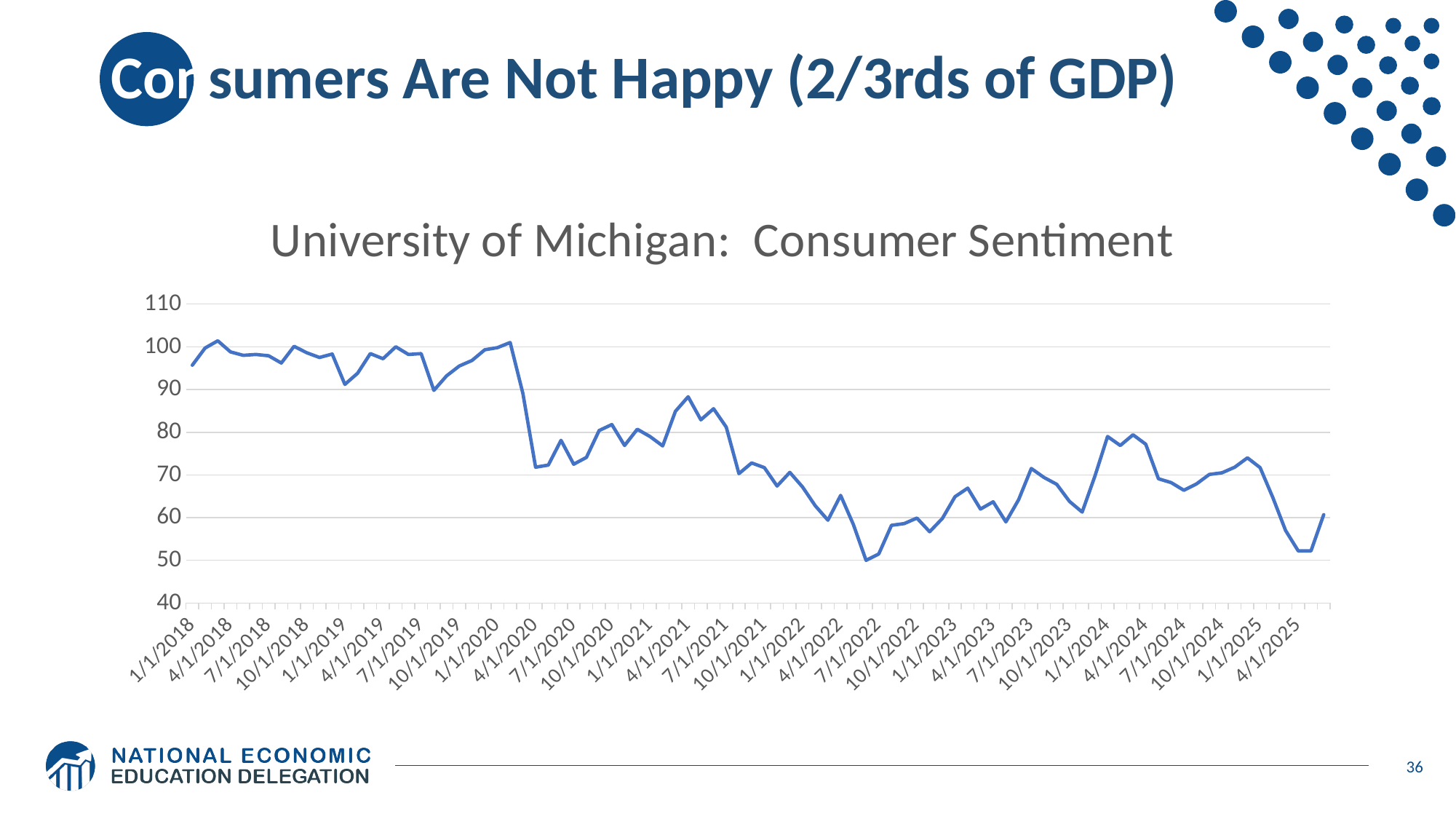
Which is larger, the value for 1/1/2018 or the value for 1/1/2022? 1/1/2018 How many date labels are shown on the x axis? 30 Which is larger, the value for 4/1/2021 or the value for 4/1/2022? 4/1/2021 What kind of chart is shown on the slide? Line chart Is the value for 7/1/2022 greater or less than 60? less Is the value for 4/1/2025 greater or less than 60? less Is the value for 4/1/2020 greater or less than 80? less What is the title of the chart? University of Michigan: Consumer Sentiment Overall, does consumer sentiment rise or fall from 1/1/2018 to 4/1/2025? Fall